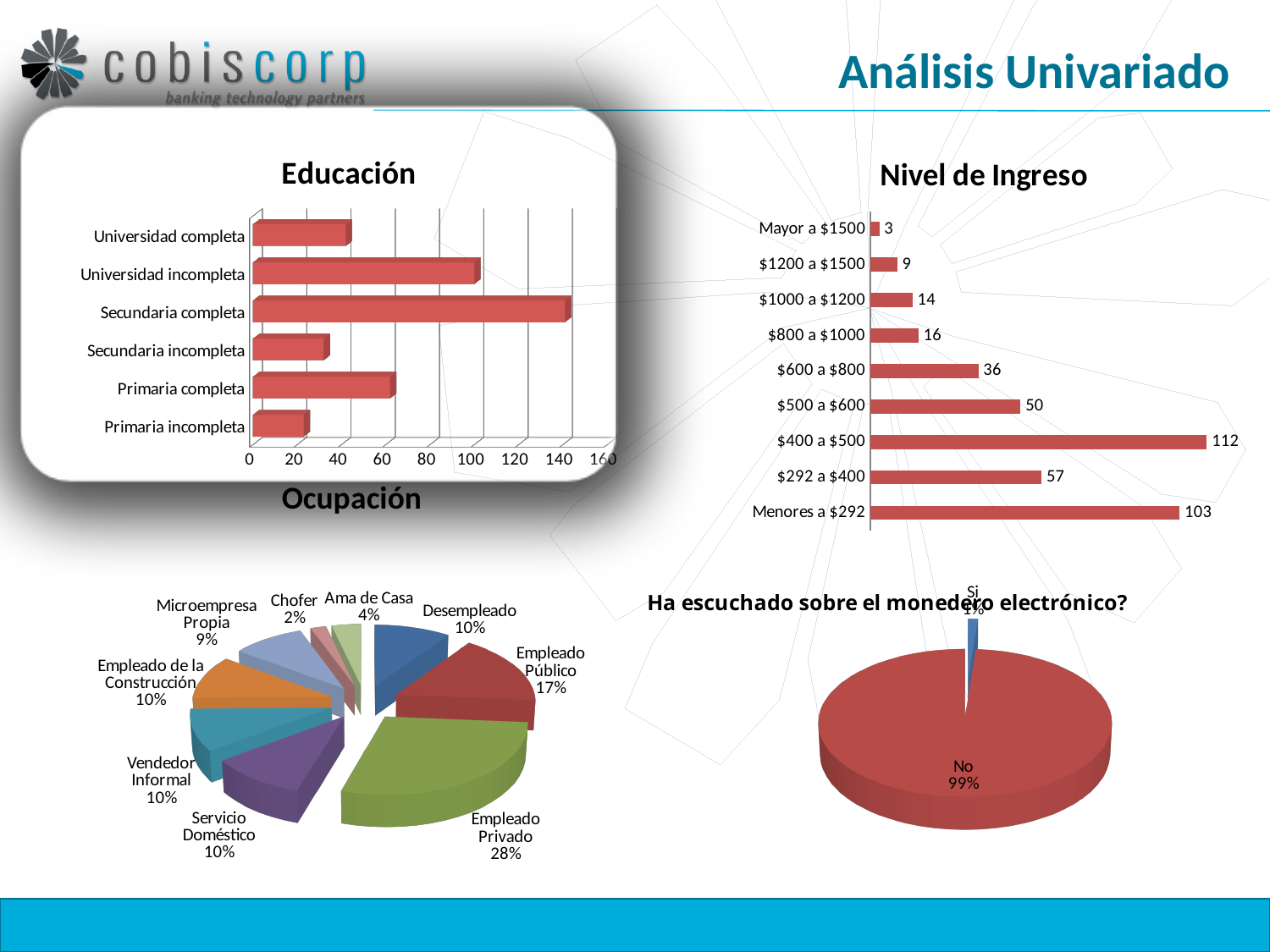
In the 'Nivel de Ingreso' chart, what is the difference between '$500 a $600' and '$600 a $800'? 14 In the 'Educación' chart, is the value for 'Universidad incompleta' greater or less than 80? greater In the 'Ocupación' pie chart, what share does 'Empleado Privado' have? 28% In the 'Nivel de Ingreso' chart, what is the value for 'Menores a $292'? 103 In the 'Ocupación' pie chart, which occupation has the smallest share? Chofer What kind of chart is the 'Educación' chart? bar chart In the 'Educación' chart, is the value for 'Primaria incompleta' greater or less than 40? less In the 'Ha escuchado sobre el monedero electrónico?' pie chart, what share answered 'No'? 99% In the 'Educación' chart, which category has the highest value? Secundaria completa In the 'Nivel de Ingreso' chart, how many income categories are shown? 9 In the 'Nivel de Ingreso' chart, which category has the lowest value? Mayor a $1500 In the 'Nivel de Ingreso' chart, what is the value for '$400 a $500'? 112